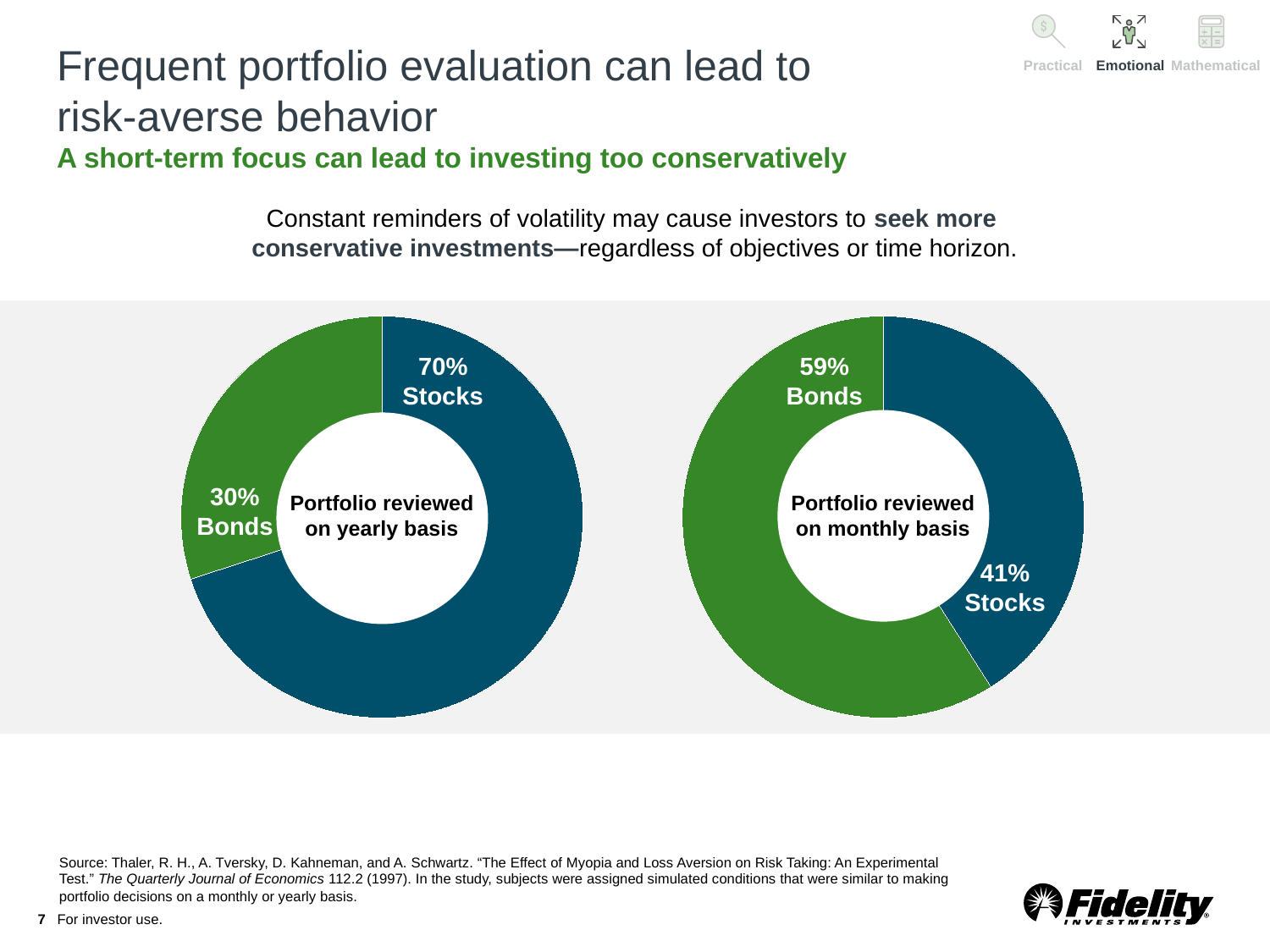
In the 'Portfolio reviewed on yearly basis' chart, what is the difference between the Stocks and Bonds percentages? 40% In the 'Portfolio reviewed on monthly basis' chart, what is the difference between the Bonds and Stocks percentages? 18% Is the Stocks share larger in the 'Portfolio reviewed on yearly basis' chart or the 'Portfolio reviewed on monthly basis' chart? Portfolio reviewed on yearly basis In the 'Portfolio reviewed on yearly basis' chart, which category has the largest share? Stocks In the 'Portfolio reviewed on yearly basis' chart, what percentage is Bonds? 30% How many categories does the 'Portfolio reviewed on monthly basis' chart show? 2 In the 'Portfolio reviewed on monthly basis' chart, which category has the smallest share? Stocks In the 'Portfolio reviewed on yearly basis' chart, what percentage is Stocks? 70% In the 'Portfolio reviewed on monthly basis' chart, what percentage is Bonds? 59% In the 'Portfolio reviewed on yearly basis' chart, what colour is the Bonds slice? Green What kind of chart is the 'Portfolio reviewed on yearly basis' chart? Doughnut chart In the 'Portfolio reviewed on monthly basis' chart, what percentage is Stocks? 41%